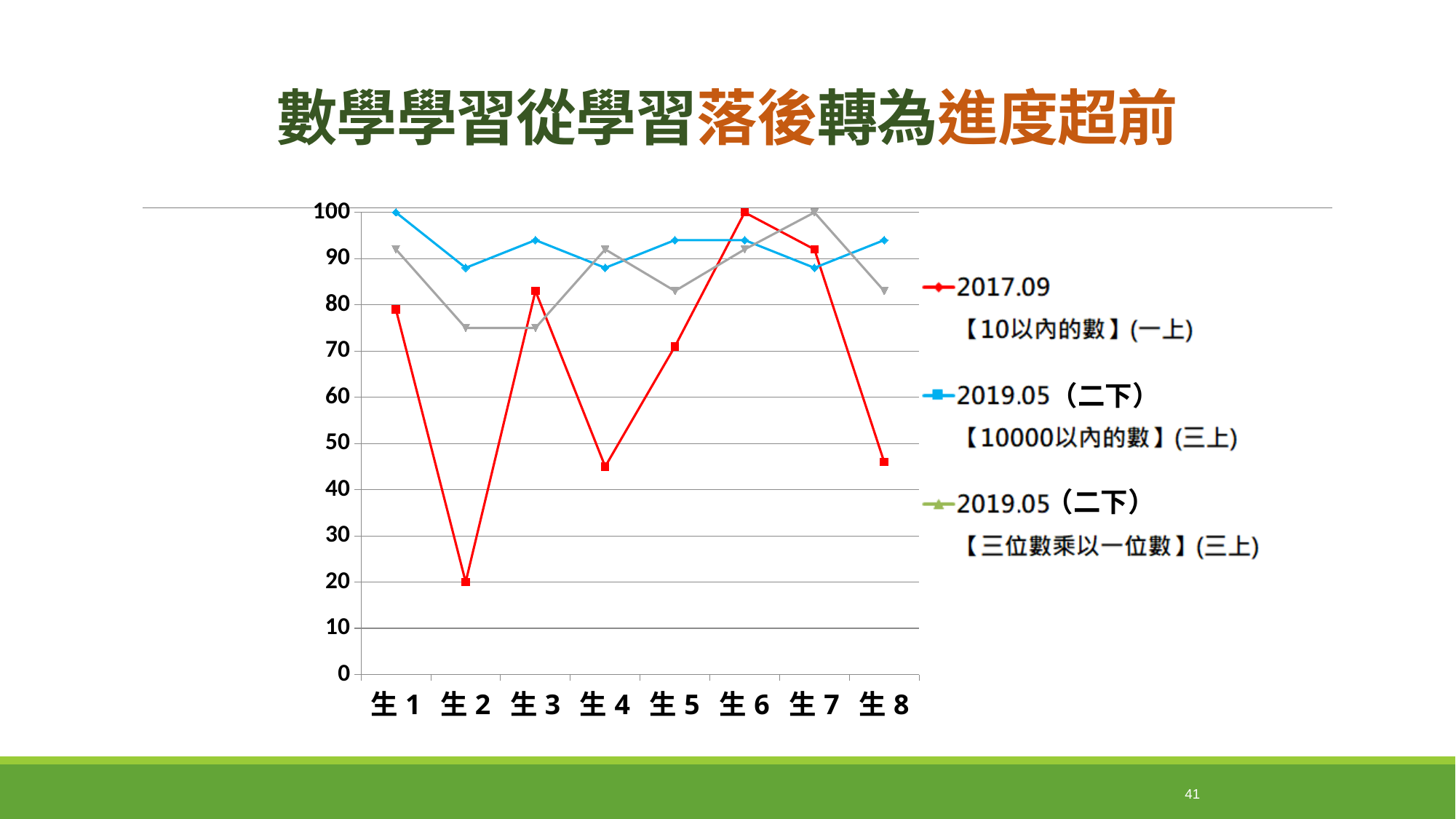
Is the value for 生 2 in the 2019.05（二下）【三位數乘以一位數】 series greater or less than 80? less How many students (categories) are shown on the x axis? 8 What colour is the line for the 2017.09 series? red For 生 2, which series has the larger value: 2017.09 or 2019.05（二下）【10000以內的數】? 2019.05（二下）【10000以內的數】 What is the value for 生 2 in the 2017.09 series? 20 Which student has the lowest value in the 2017.09 series? 生 2 Is the value for 生 4 in the 2017.09 series greater or less than 50? less How many series does the legend list? 3 What is the value for 生 1 in the 2019.05（二下）【10000以內的數】 series? 100 What kind of chart is shown on the slide? line chart Which student has the highest value in the 2017.09 series? 生 6 What is the value for 生 6 in the 2017.09 series? 100